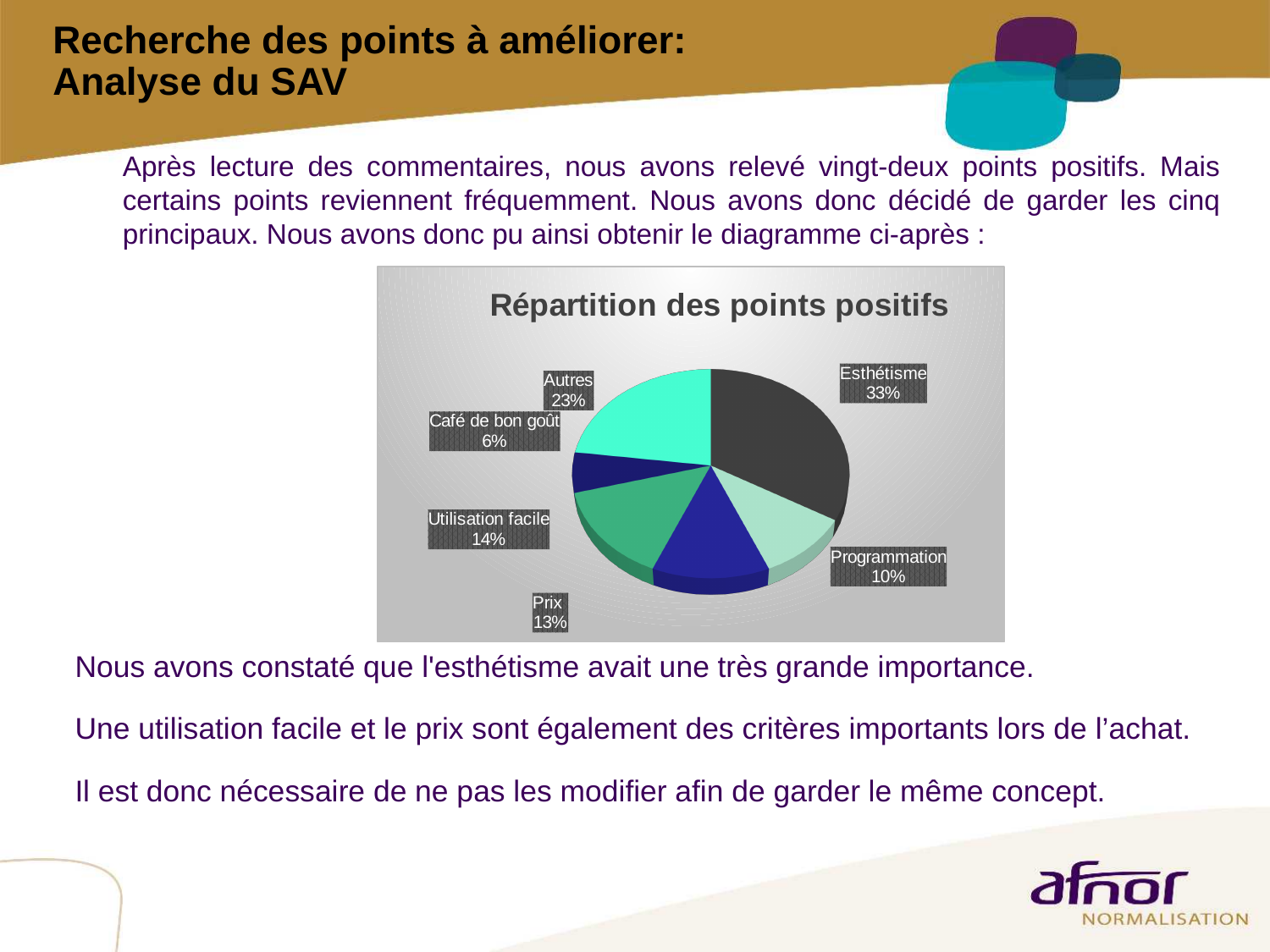
What kind of chart is shown on the slide? pie chart What is the value shown for Utilisation facile? 14% What is the difference in percentage points between Esthétisme and Autres? 10 What is the value shown for Programmation? 10% What is the value shown for Prix? 13% What is the title of the pie chart? Répartition des points positifs What is the value shown for Café de bon goût? 6% How many slices does the pie chart have? 6 Which category has the largest share of the pie? Esthétisme Which is larger, the share for Utilisation facile or the share for Programmation? Utilisation facile Which category has the smallest share of the pie? Café de bon goût What share of the pie does Esthétisme represent? 33%